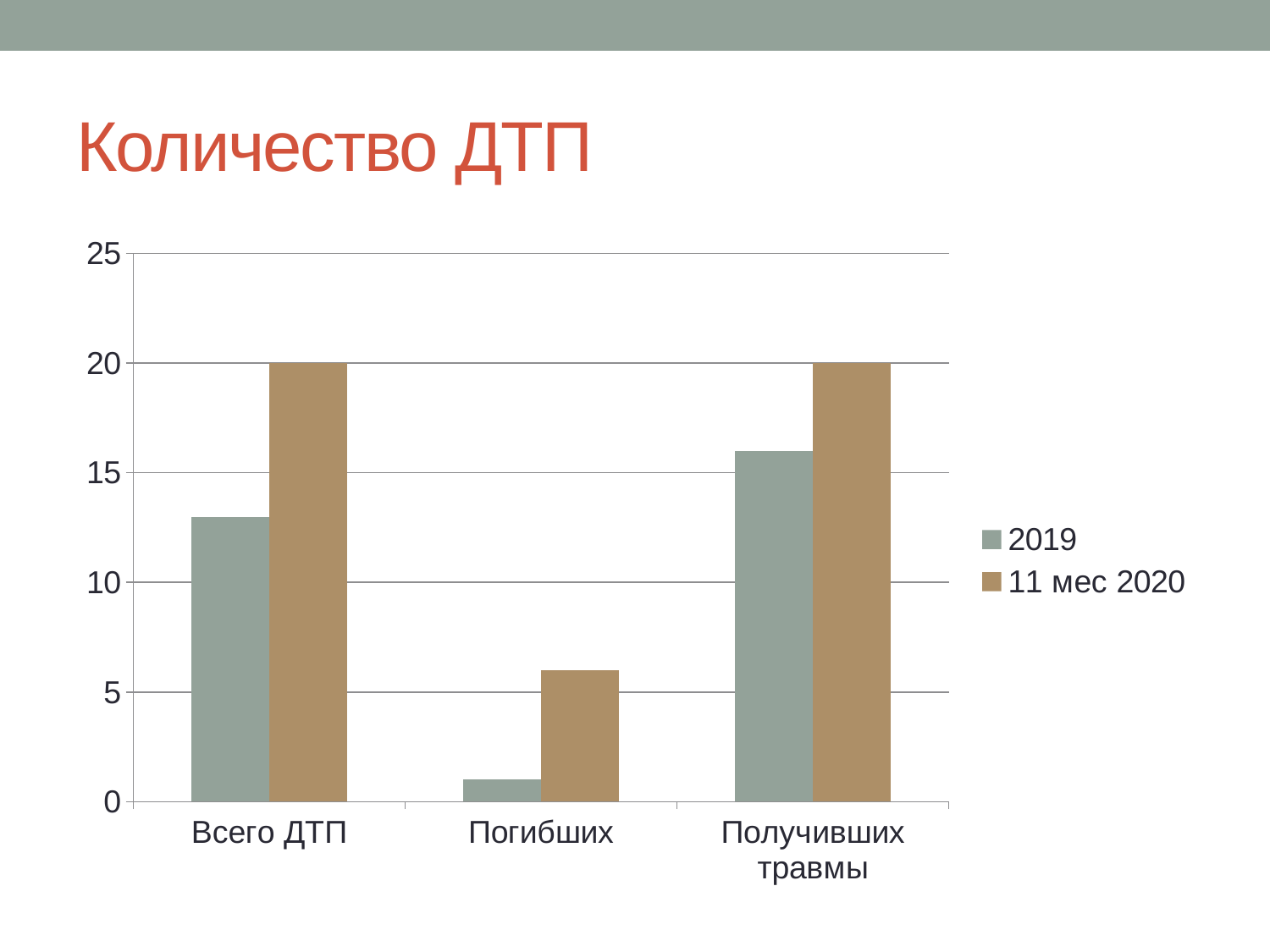
What kind of chart is shown on the slide? bar chart Is the value for Всего ДТП in the 2019 series greater or less than 15? less What is the value for Получивших травмы in the 11 мес 2020 series? 20 Which is larger for Погибших: the 2019 value or the 11 мес 2020 value? 11 мес 2020 Is the value for Погибших in the 2019 series greater or less than 5? less How many series does the legend list? 2 Is the value for Погибших in the 11 мес 2020 series greater or less than 5? greater How many categories are shown on the x axis? 3 Which category has the lowest value in the 2019 series? Погибших What is the value for Всего ДТП in the 11 мес 2020 series? 20 What is the title of the chart? Количество ДТП